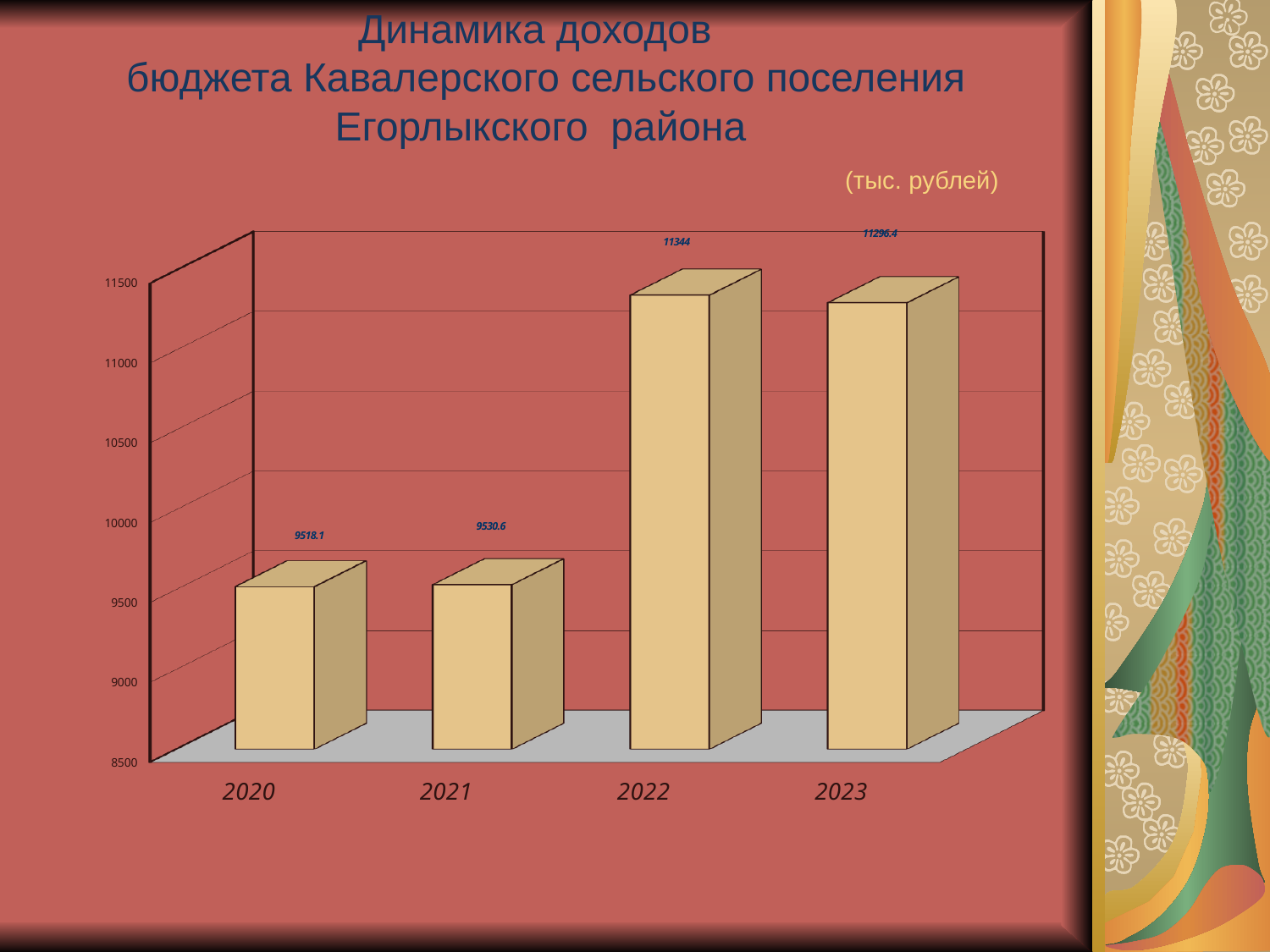
What kind of chart is shown on the slide? bar chart In what units are the values given, according to the slide? тыс. рублей What is the value for 2020? 9518.1 Which is larger, the value for 2022 or the value for 2023? 2022 Which year has the lowest value? 2020 Which year has the highest value? 2022 How many years are shown on the x axis? 4 What is the difference between the values for 2022 and 2021? 1813.4 What is the value for 2021? 9530.6 What is the value for 2023? 11296.4 Is the value for 2020 greater or less than 10000? less What is the value for 2022? 11344